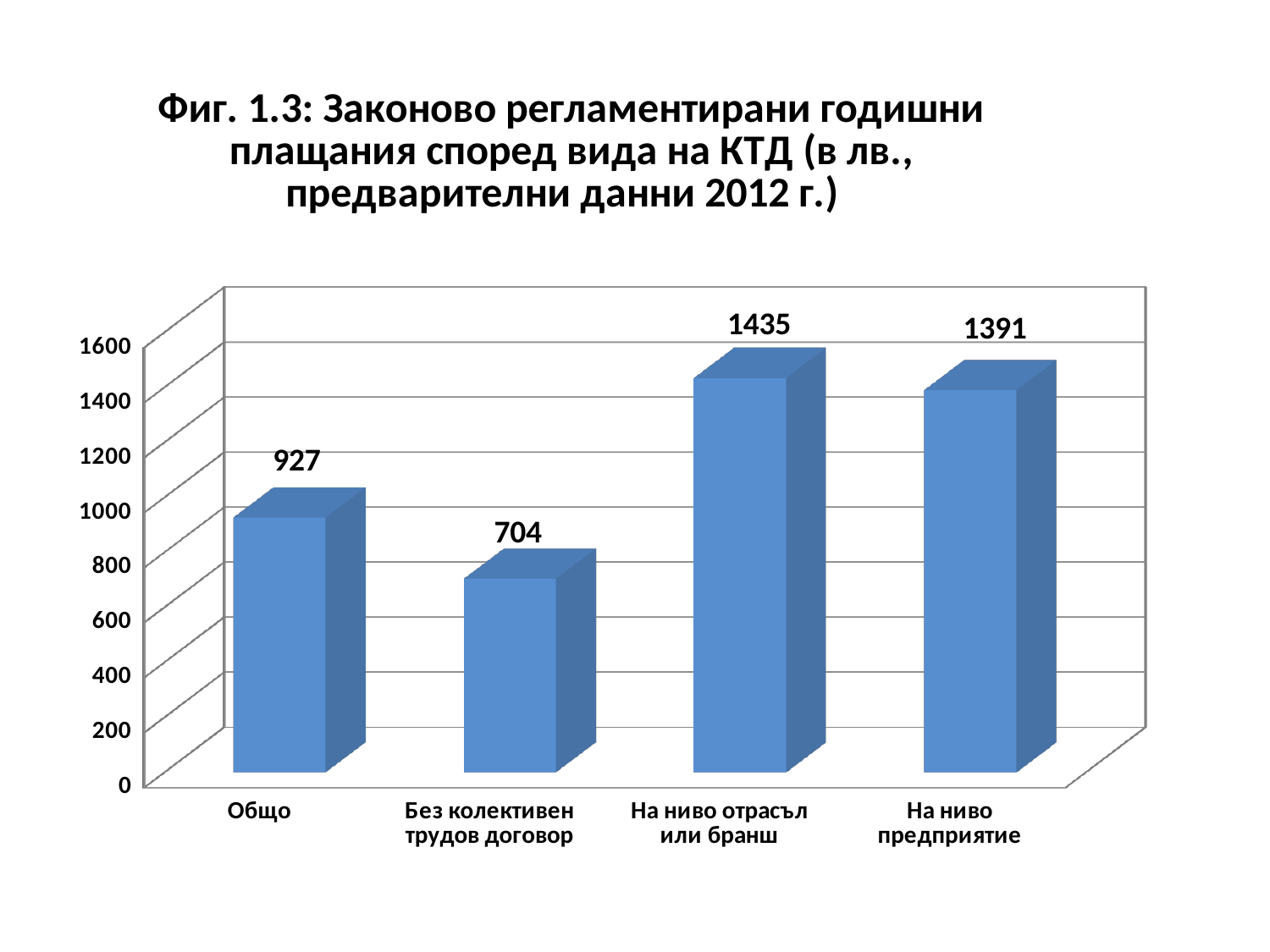
What is the difference between the values for Общо and Без колективен трудов договор? 223 How many categories are shown on the chart? 4 What is the highest value shown on the vertical axis? 1600 What is the difference between the values for На ниво отрасъл или бранш and На ниво предприятие? 44 What kind of chart is shown on the slide? Bar chart What is the value for На ниво предприятие? 1391 What is the value for Общо? 927 Which category has the highest value? На ниво отрасъл или бранш What is the value for На ниво отрасъл или бранш? 1435 Which category has the lowest value? Без колективен трудов договор What is the value for Без колективен трудов договор? 704 Which is larger, the value for Общо or the value for Без колективен трудов договор? Общо